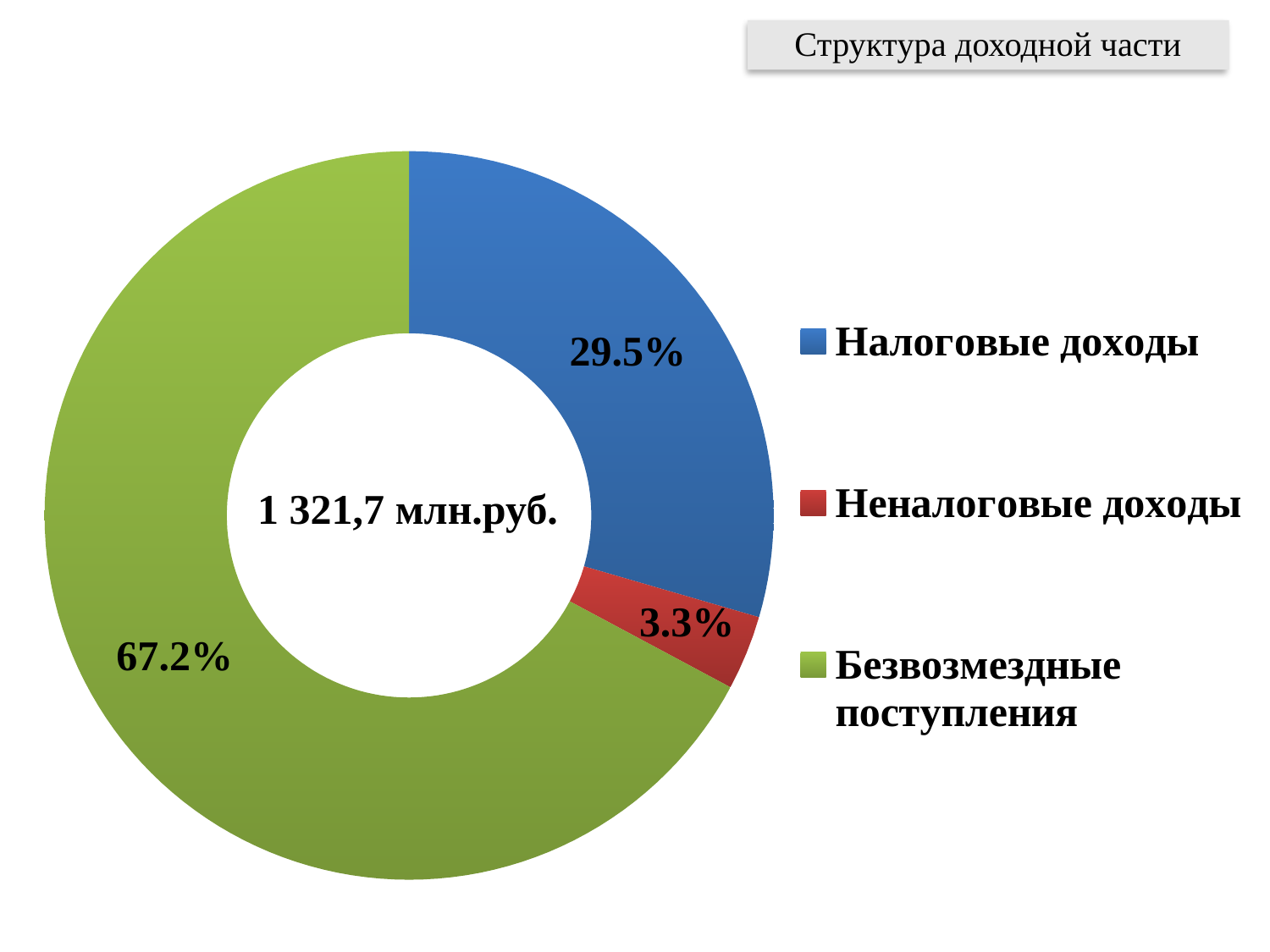
What share of the chart does Безвозмездные поступления represent? 67.2% Which is larger, the share for Налоговые доходы or the share for Неналоговые доходы? Налоговые доходы What kind of chart is shown on the slide? Doughnut (pie) chart Which category has the largest share of the chart? Безвозмездные поступления What share of the chart does Налоговые доходы represent? 29.5% Which category has the smallest share of the chart? Неналоговые доходы How many categories does the chart show? 3 What total value is printed in the centre of the chart? 1 321,7 млн.руб. What share of the chart does Неналоговые доходы represent? 3.3% What is the difference in percentage points between Налоговые доходы and Неналоговые доходы? 26.2 What is the difference in percentage points between Безвозмездные поступления and Налоговые доходы? 37.7 What colour represents Безвозмездные поступления in the chart? Green